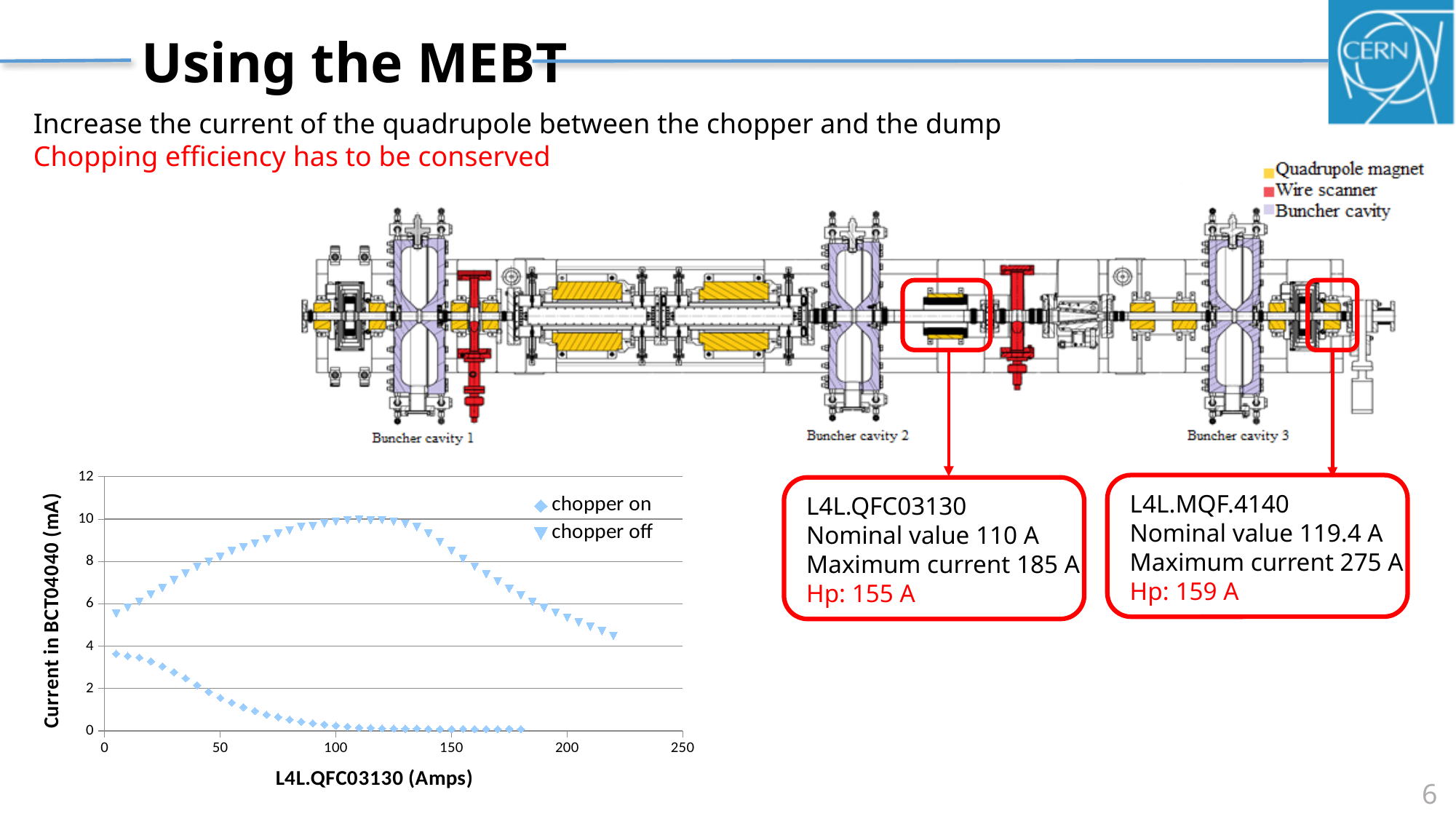
Is the value of the chopper off series at 220 Amps greater or less than 6? less Is the value of the chopper off series at 100 Amps greater or less than 8? greater What is the title of the y axis of the chart? Current in BCT04040 (mA) Does the chopper on series rise or fall as the current on the x axis increases? fall Is the value of the chopper on series at 100 Amps greater or less than 2? less Does the chopper off series rise or fall between 150 and 220 Amps on the x axis? fall What kind of chart is shown at the bottom left of the slide? scatter chart At 50 Amps, which series has the higher current: chopper on or chopper off? chopper off Does the chopper off series rise or fall between 0 and 100 Amps on the x axis? rise What is the title of the x axis of the chart? L4L.QFC03130 (Amps) How many series does the legend of the scatter chart list? 2